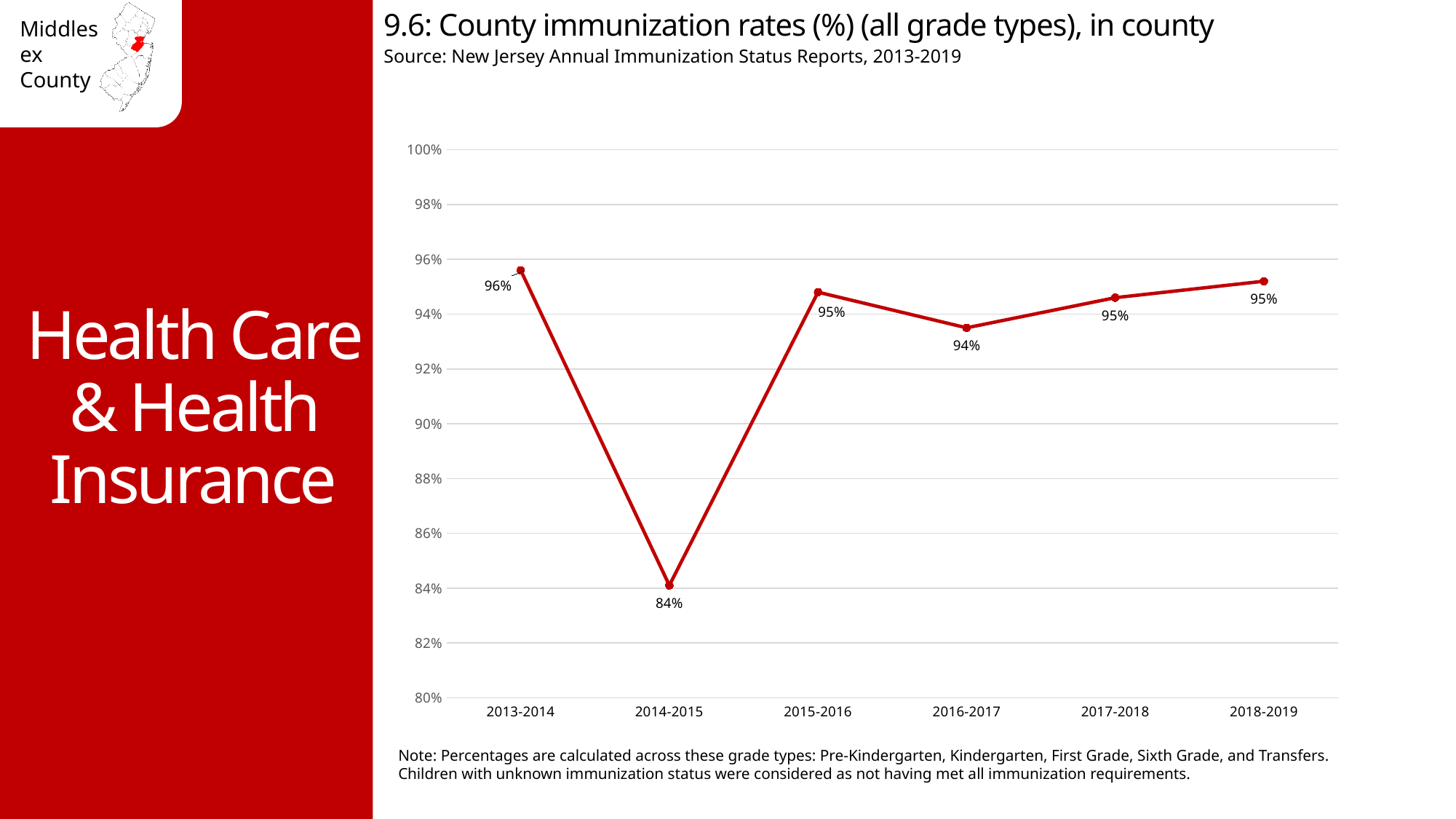
Which year had a higher immunization rate, 2015-2016 or 2016-2017? 2015-2016 Did the immunization rate rise or fall from 2016-2017 to 2018-2019? rise Is the immunization rate for 2014-2015 greater or less than 90%? less What kind of chart is used to show the county immunization rates? line chart Which school year had the lowest county immunization rate? 2014-2015 What was the county immunization rate in 2014-2015? 84% What was the county immunization rate in 2013-2014? 96% What was the county immunization rate in 2018-2019? 95% How many school years are plotted on the chart? 6 What is the difference in percentage points between the immunization rate in 2013-2014 and in 2014-2015? 12 percentage points Which school year had the highest county immunization rate? 2013-2014 What was the county immunization rate in 2016-2017? 94%